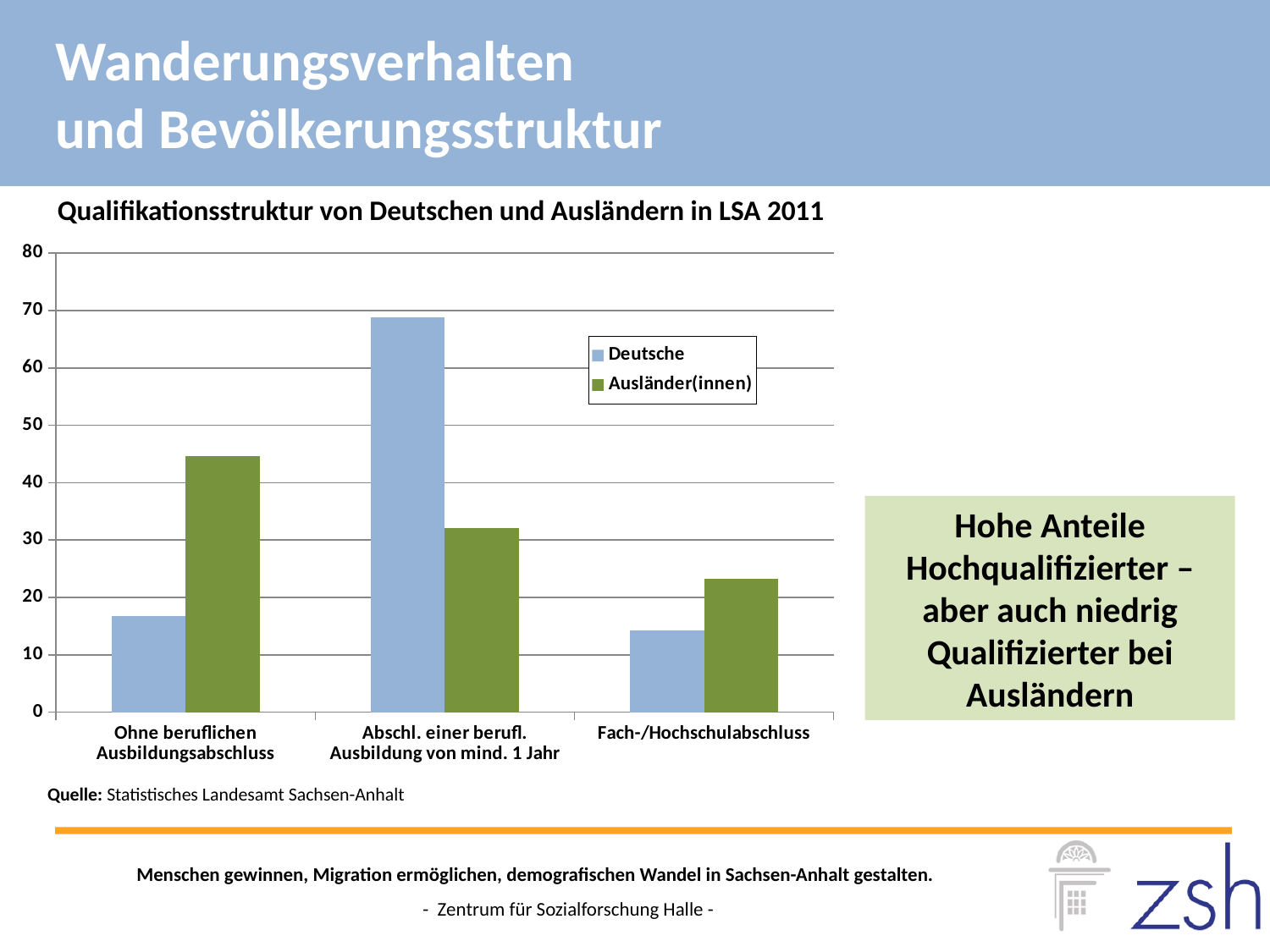
Which series is shown in green? Ausländer(innen) How many series does the legend list? 2 How many categories are shown on the x axis? 3 For which category is the Deutsche value lowest? Fach-/Hochschulabschluss For which category is the Deutsche value highest? Abschl. einer berufl. Ausbildung von mind. 1 Jahr What kind of chart is shown on the slide? bar chart For 'Ohne beruflichen Ausbildungsabschluss', which series has the larger value, Deutsche or Ausländer(innen)? Ausländer(innen) Is the Deutsche value for 'Fach-/Hochschulabschluss' greater or less than 20? less Is the Deutsche value for 'Abschl. einer berufl. Ausbildung von mind. 1 Jahr' greater or less than 60? greater For 'Abschl. einer berufl. Ausbildung von mind. 1 Jahr', which series has the larger value, Deutsche or Ausländer(innen)? Deutsche For which category is the Ausländer(innen) value highest? Ohne beruflichen Ausbildungsabschluss What is the title of the chart? Qualifikationsstruktur von Deutschen und Ausländern in LSA 2011